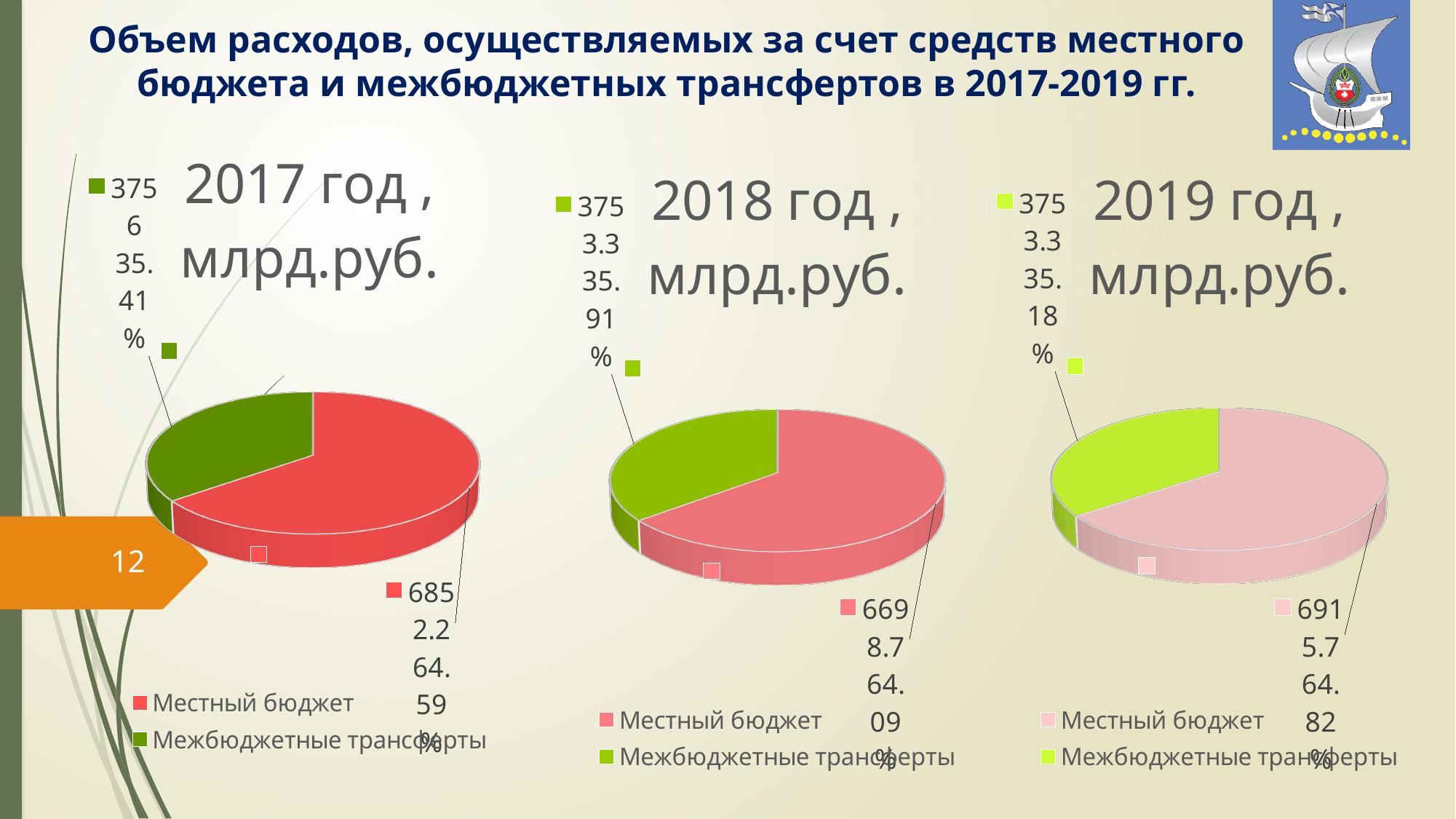
In the 2018 год chart, what share of the pie is Межбюджетные трансферты? 35.91% In the 2018 год chart, which category has the smallest slice? Межбюджетные трансферты What kind of chart is used for the 2017 год chart? pie chart In the 2017 год chart, what share of the pie is Местный бюджет? 64.59% In the 2018 год chart, what share of the pie is Местный бюджет? 64.09% How many pie charts are shown on the slide? 3 How many entries does the legend of the 2019 год chart list? 2 In the 2019 год chart, which slice is larger, Местный бюджет or Межбюджетные трансферты? Местный бюджет How many slices does the 2018 год pie chart have? 2